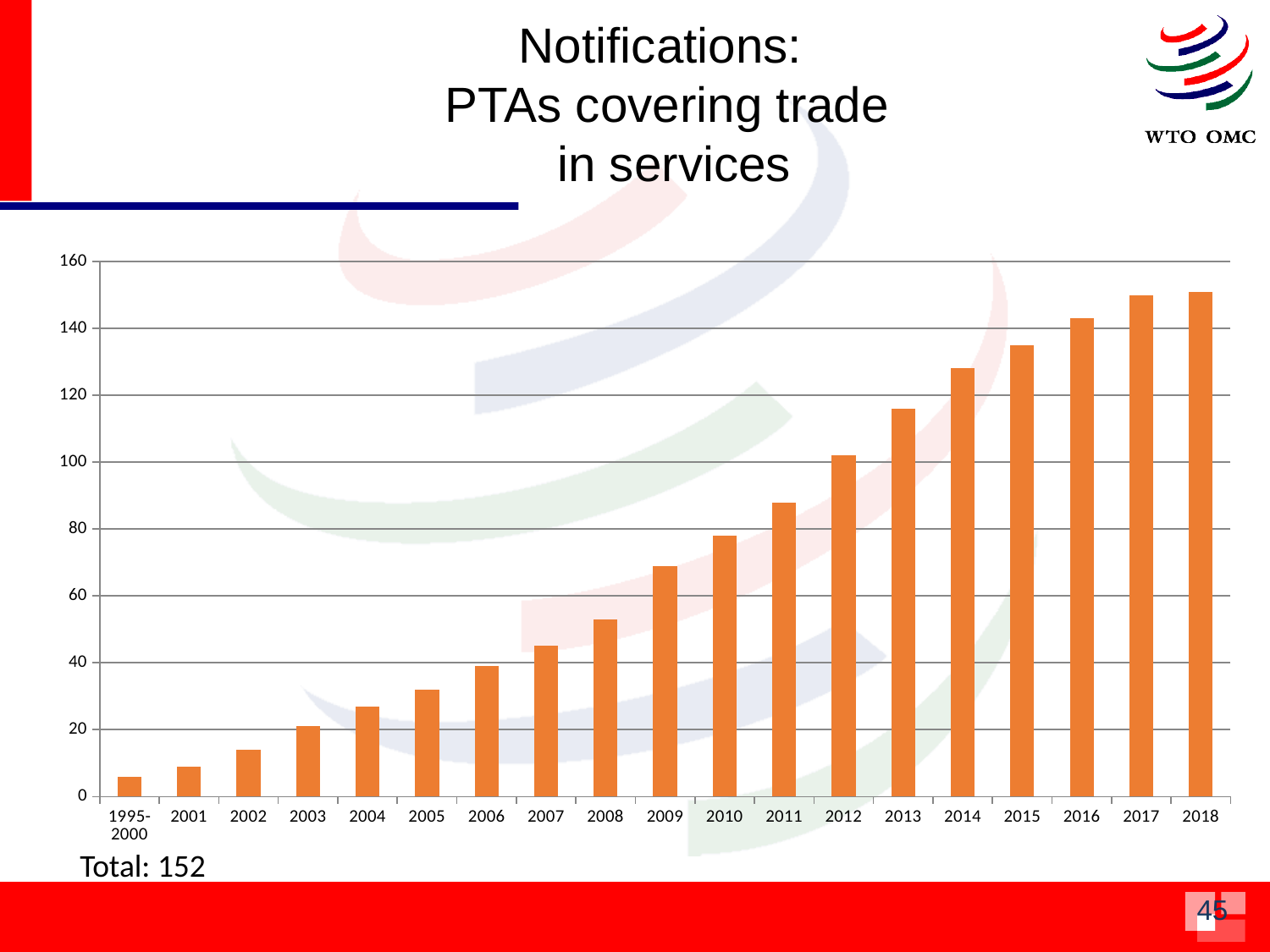
What total is stated in the text below the chart? 152 Which category has the lowest value in the chart? 1995-2000 How many categories are shown on the x axis of the chart? 19 Which is larger, the value for 2013 or the value for 2015? 2015 Is the value for 2004 greater or less than 20? greater Is the value for 2013 greater or less than 120? less What kind of chart is shown on the slide? bar chart Is the value for 2014 greater or less than 120? greater Do the values generally rise or fall from left to right along the x axis? rise Which is larger, the value for 2005 or the value for 2007? 2007